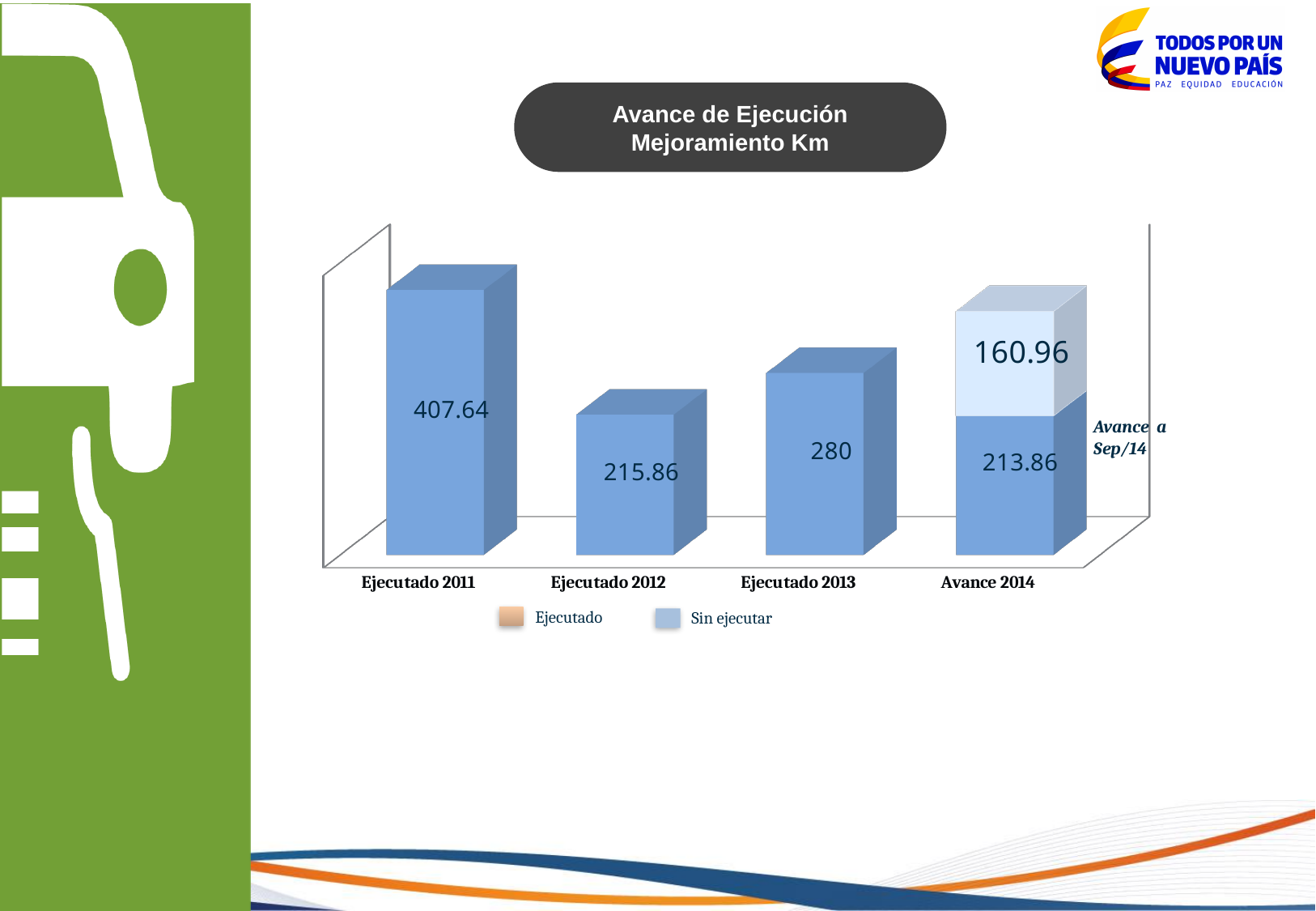
How many series does the legend list? 2 What is the difference between the values for Ejecutado 2011 and Ejecutado 2012? 191.78 What is the value shown for Ejecutado 2013? 280 Which is larger, the value for Ejecutado 2013 or the value for Ejecutado 2012? Ejecutado 2013 What is the value shown for Ejecutado 2011? 407.64 What is the total of the stacked Avance 2014 bar? 374.82 Which category has the shortest bar? Ejecutado 2012 Which category has the tallest bar? Ejecutado 2011 What is the value of the lower (darker) segment of the Avance 2014 bar? 213.86 What is the value of the upper (lighter) segment of the Avance 2014 bar? 160.96 How many categories are shown on the x axis? 4 What is the value shown for Ejecutado 2012? 215.86